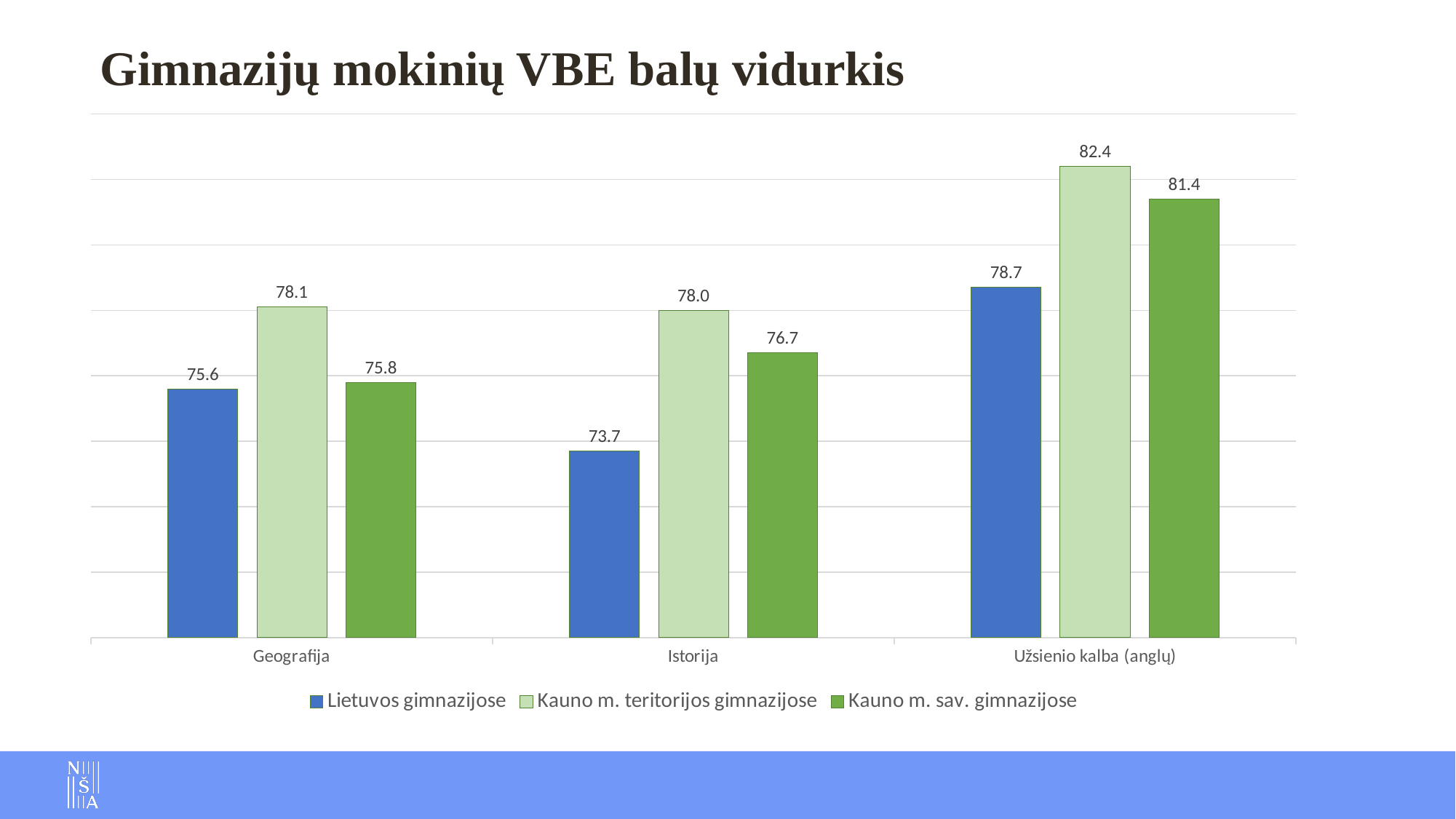
In the Geografija category, which is larger: Kauno m. teritorijos gimnazijose or Kauno m. sav. gimnazijose? Kauno m. teritorijos gimnazijose What is the value for Lietuvos gimnazijose in the Geografija category? 75.6 What is the value for Kauno m. sav. gimnazijose in the Užsienio kalba (anglų) category? 81.4 How many series does the legend list? 3 What is the value for Kauno m. teritorijos gimnazijose in the Istorija category? 78.0 What is the difference between Kauno m. teritorijos gimnazijose and Lietuvos gimnazijose in the Istorija category? 4.3 What is the difference between Kauno m. teritorijos gimnazijose and Kauno m. sav. gimnazijose in the Užsienio kalba (anglų) category? 1.0 How many categories are shown on the x axis? 3 What kind of chart is shown on the slide? Bar chart Which category has the lowest value for Lietuvos gimnazijose? Istorija Which category has the highest value for Kauno m. teritorijos gimnazijose? Užsienio kalba (anglų) What is the title of the chart? Gimnazijų mokinių VBE balų vidurkis